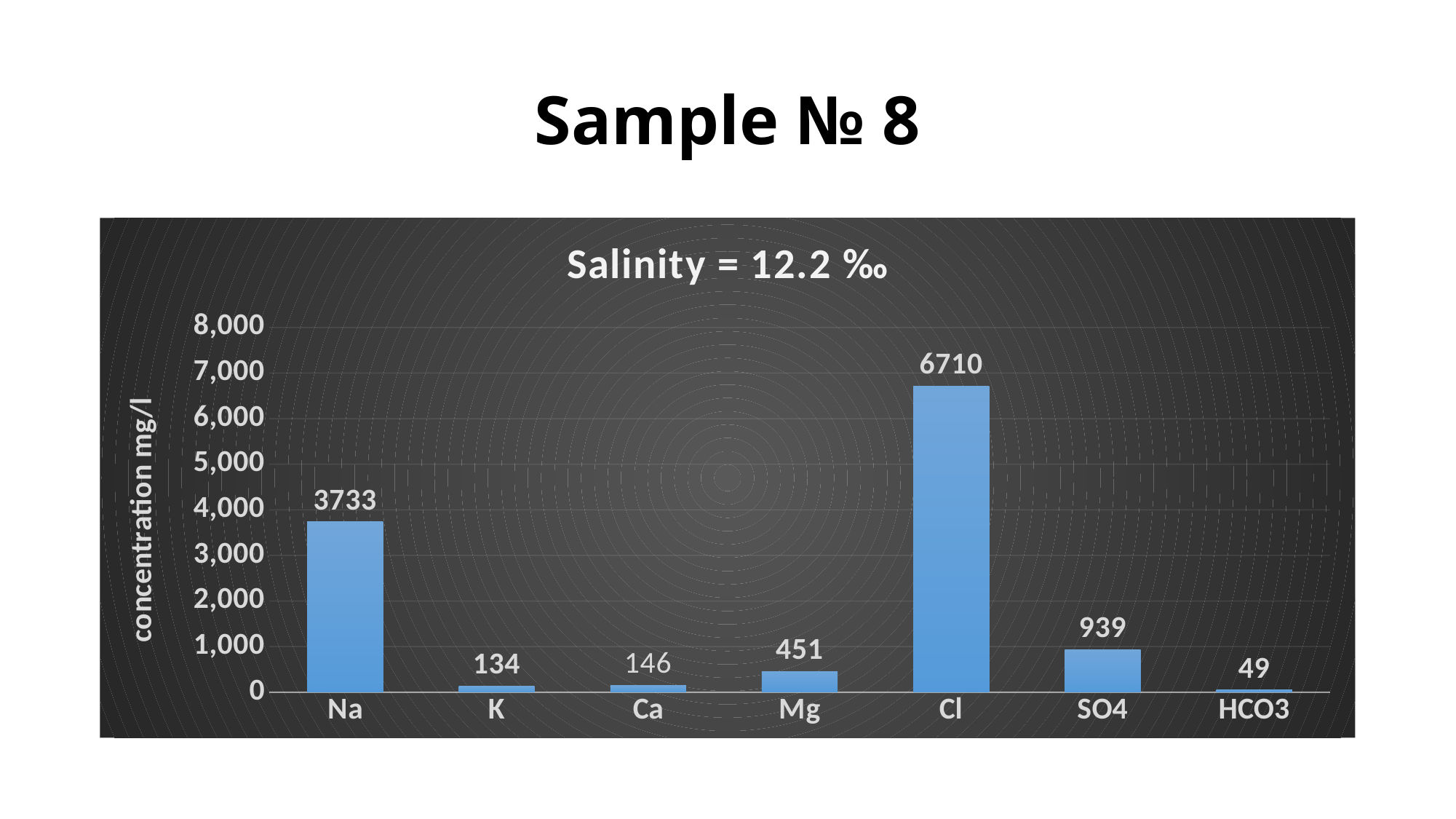
What is the difference between the concentrations of Mg and K? 317 How many ions are shown on the x axis? 7 What is the chart's title? Salinity = 12.2 ‰ What is the concentration of Cl? 6710 Which ion has the highest concentration? Cl What is the concentration of HCO3? 49 Which ion has the lowest concentration? HCO3 What is the concentration of SO4? 939 What is the difference between the concentrations of Cl and Na? 2977 What type of chart is shown? Bar chart What is the concentration of Na? 3733 Which has a higher concentration, SO4 or Mg? SO4